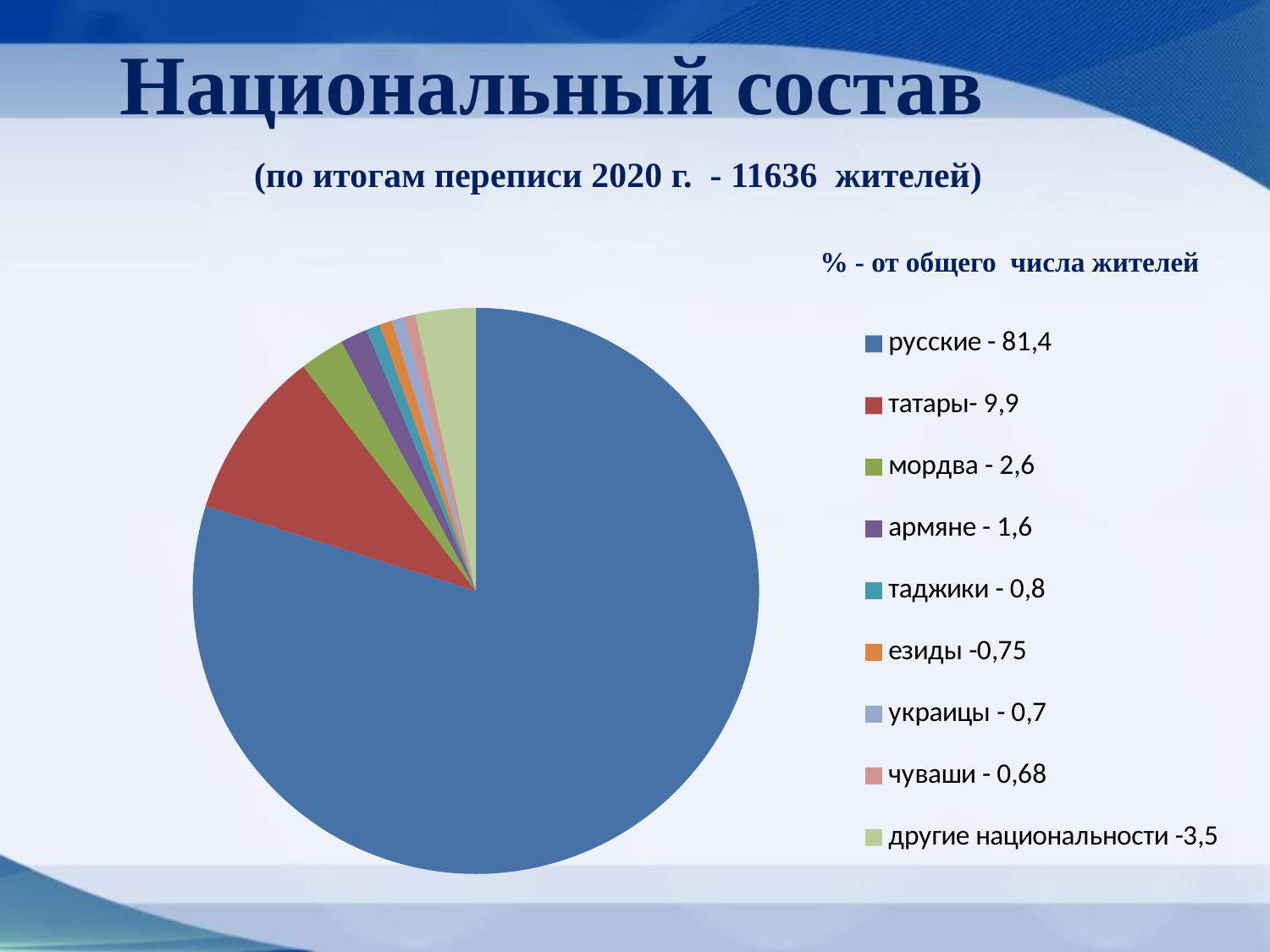
What is the value for езиды in the pie chart? 0,75 Which category has the largest slice of the pie chart? русские What is the difference between the values for татары and другие национальности? 6,4 What is the value for мордва in the pie chart? 2,6 Which is larger, the value for армяне or the value for таджики? армяне Which category has the smallest value in the pie chart? чуваши What is the value for татары in the pie chart? 9,9 What is the difference between the values for русские and татары? 71,5 How many categories does the pie chart have? 9 What kind of chart is shown on the slide? pie chart What is the title of the slide containing the pie chart? Национальный состав What is the value for русские in the pie chart? 81,4